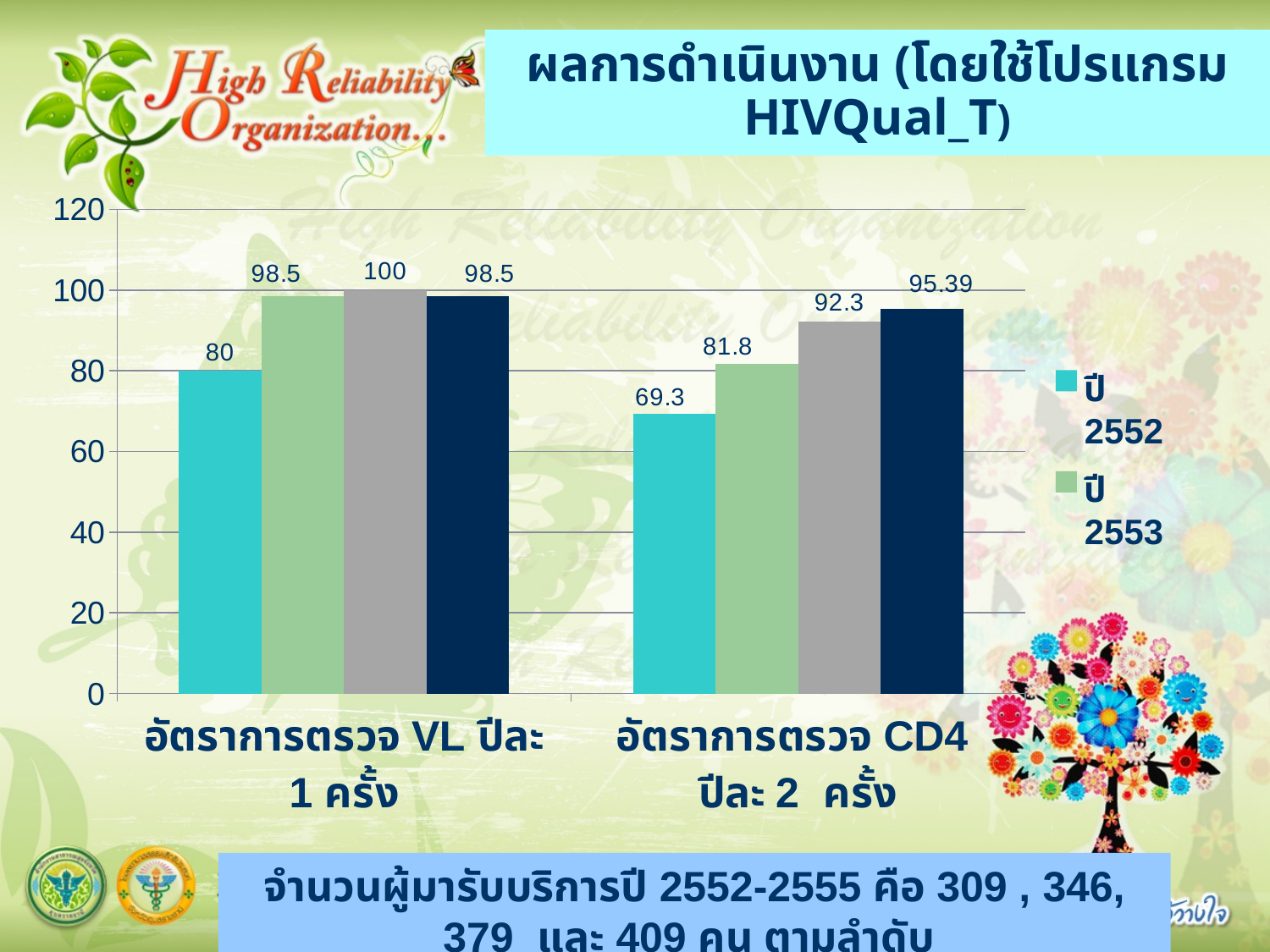
How many categories are shown on the x axis of the chart? 2 For ปี 2552, which category has the larger value: อัตราการตรวจ VL ปีละ 1 ครั้ง or อัตราการตรวจ CD4 ปีละ 2 ครั้ง? อัตราการตรวจ VL ปีละ 1 ครั้ง What kind of chart is shown on the slide? bar chart What is the value for ปี 2553 in the อัตราการตรวจ VL ปีละ 1 ครั้ง category? 98.5 Is the value for ปี 2552 in the อัตราการตรวจ CD4 ปีละ 2 ครั้ง category greater or less than 80? less What is the value for ปี 2553 in the อัตราการตรวจ CD4 ปีละ 2 ครั้ง category? 81.8 What is the lowest value shown in the อัตราการตรวจ CD4 ปีละ 2 ครั้ง category? 69.3 What is the difference between the ปี 2553 and ปี 2552 values for อัตราการตรวจ CD4 ปีละ 2 ครั้ง? 12.5 What is the highest value shown in the อัตราการตรวจ VL ปีละ 1 ครั้ง category? 100 What is the value for ปี 2552 in the อัตราการตรวจ VL ปีละ 1 ครั้ง category? 80 What is the value for ปี 2552 in the อัตราการตรวจ CD4 ปีละ 2 ครั้ง category? 69.3 How much higher is the ปี 2553 value than the ปี 2552 value for อัตราการตรวจ VL ปีละ 1 ครั้ง? 18.5